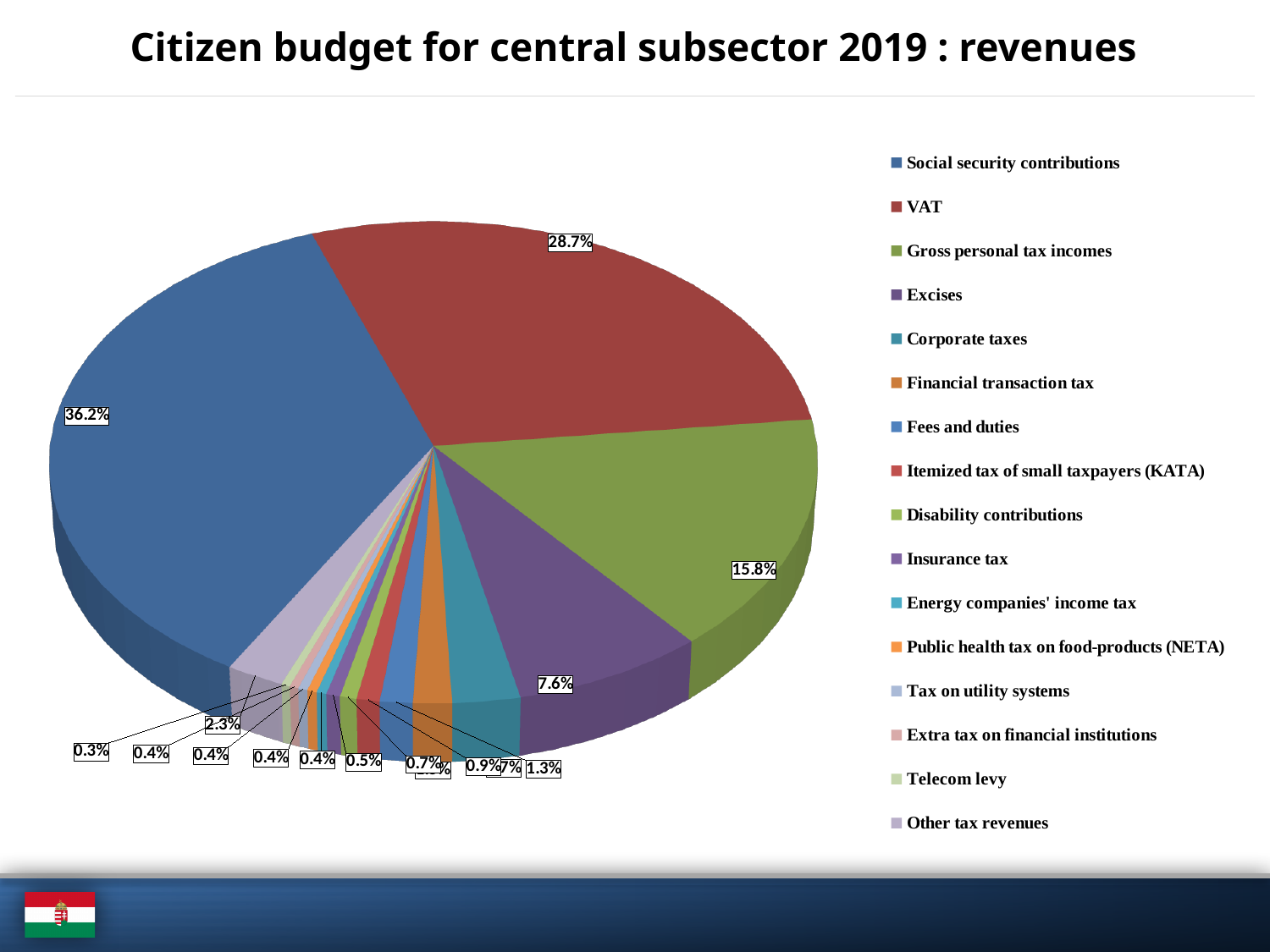
Which revenue category has the largest share of the pie? Social security contributions How many revenue categories does the legend list? 16 Which has a larger share, VAT or Gross personal tax incomes? VAT What is the smallest percentage labelled on the pie chart? 0.3% What share of revenues comes from Other tax revenues? 2.3% What share of revenues comes from Excises? 7.6% What kind of chart is shown on the slide? pie chart What is the title of the chart on the slide? Citizen budget for central subsector 2019 : revenues What share of revenues comes from Gross personal tax incomes? 15.8% How many percentage points larger is the share of Social security contributions than the share of VAT? 7.5 What share of revenues comes from Social security contributions? 36.2% What share of revenues comes from VAT? 28.7%